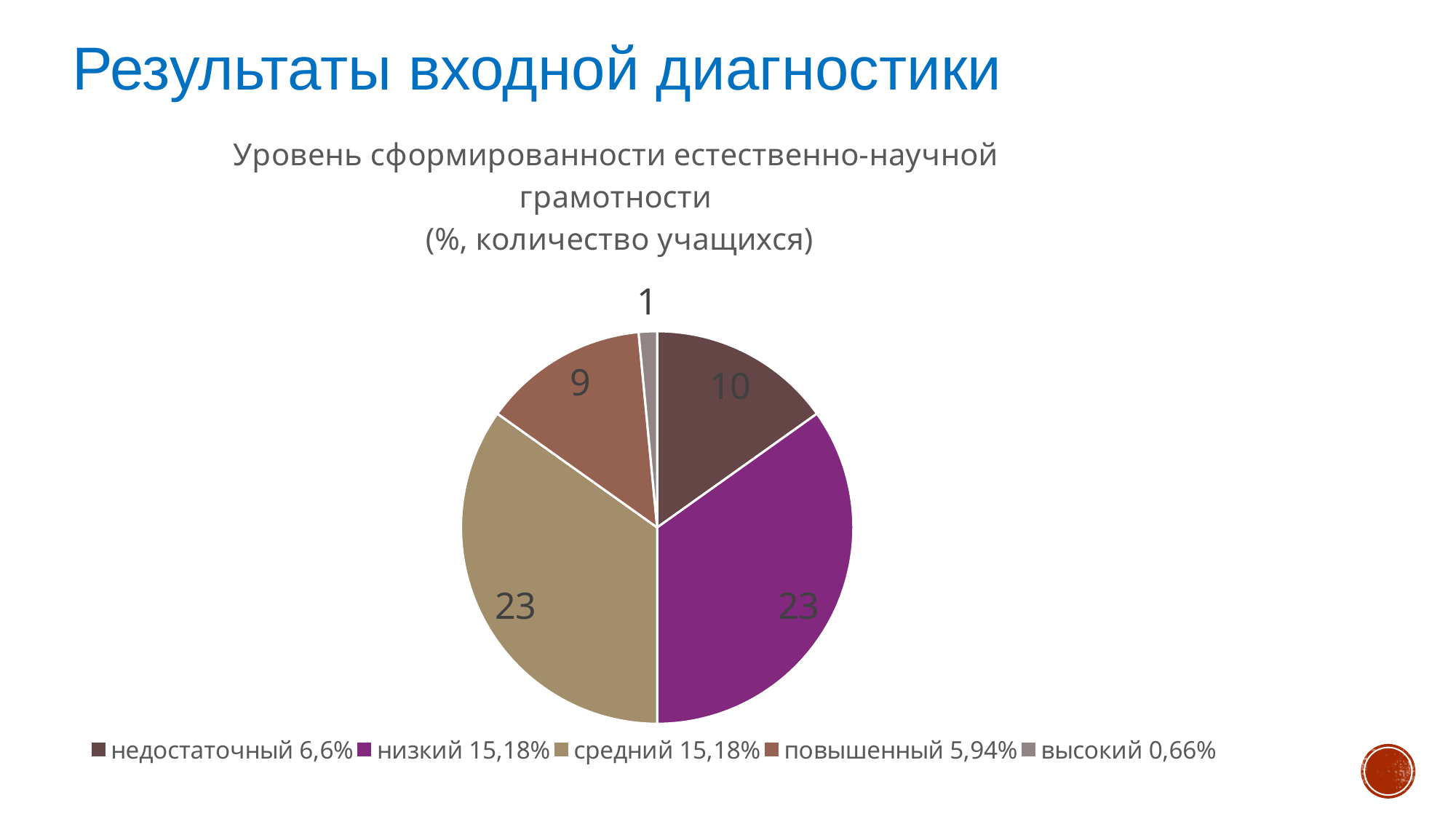
How many slices does the pie chart have? 5 Which category has the smallest slice in the pie chart? высокий What is the value shown for the средний slice? 23 What is the difference between the values for низкий and недостаточный? 13 What percentage does the legend show next to высокий? 0,66% What is the difference between the values for повышенный and высокий? 8 What is the value shown for the недостаточный slice? 10 What is the total of all the values shown on the pie chart? 66 What is the value shown for the повышенный slice? 9 What is the value shown for the высокий slice? 1 What type of chart is shown on the slide? pie chart Which is larger, the value for недостаточный or the value for повышенный? недостаточный